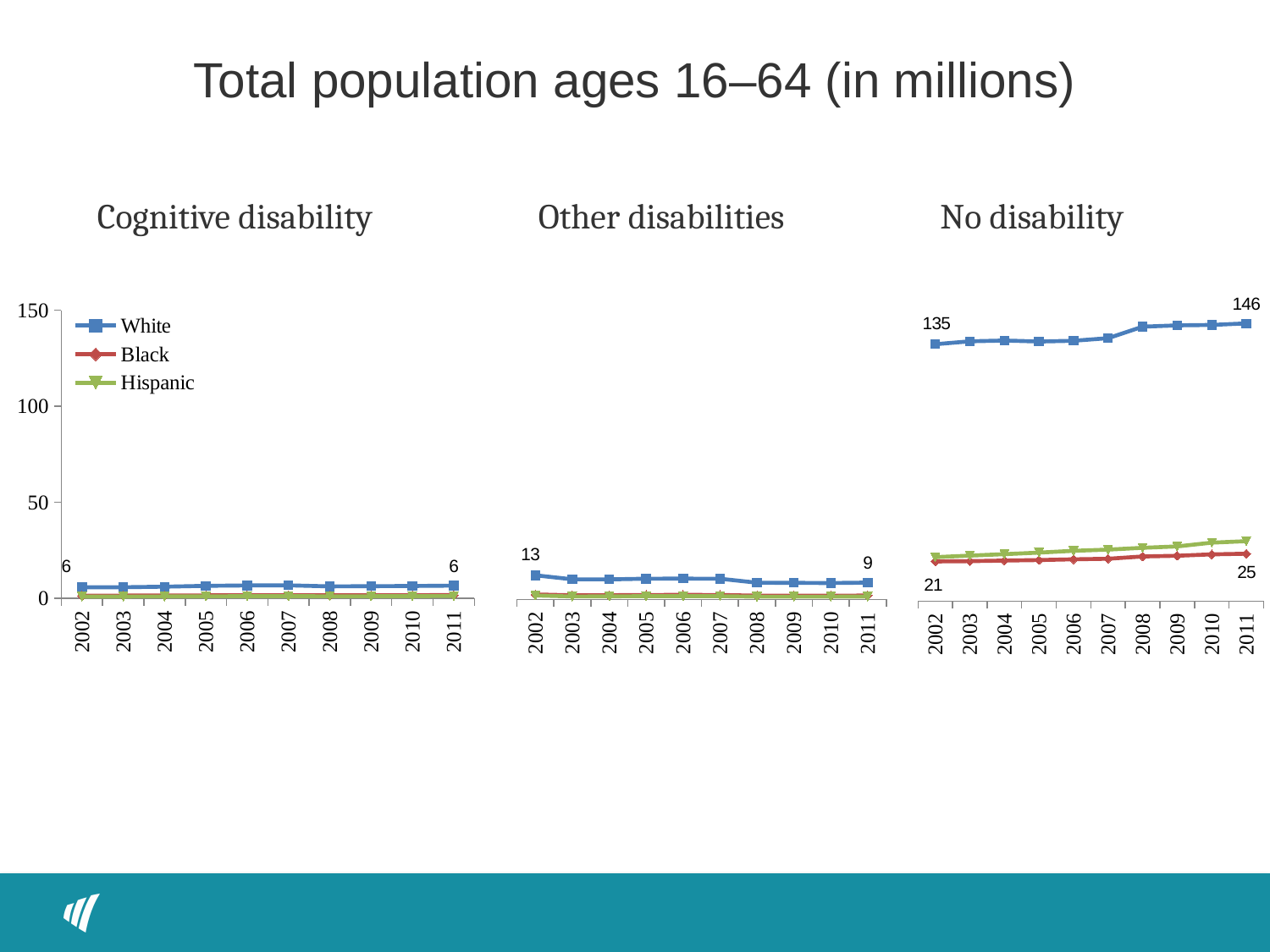
In the 'Other disabilities' chart, does the White series rise or fall from 2002 to 2011? fall How many years are shown on the x axis of the 'No disability' chart? 10 In the 'No disability' chart, by how much did the White value increase from 2002 to 2011? 11 How many series does the legend in the 'Cognitive disability' chart list? 3 In the 'No disability' chart, what is the value for White in 2002? 135 In the 'Other disabilities' chart, what is the value for White in 2011? 9 In the 'Other disabilities' chart, what is the value for White in 2002? 13 What kind of chart is the 'No disability' chart? line chart In the 'Other disabilities' chart, what is the difference between the White value in 2002 and in 2011? 4 In the 'No disability' chart, what is the value for White in 2011? 146 In the 'No disability' chart, does the White series rise or fall from 2002 to 2011? rise In the 'Cognitive disability' chart, what is the value for White in 2011? 6